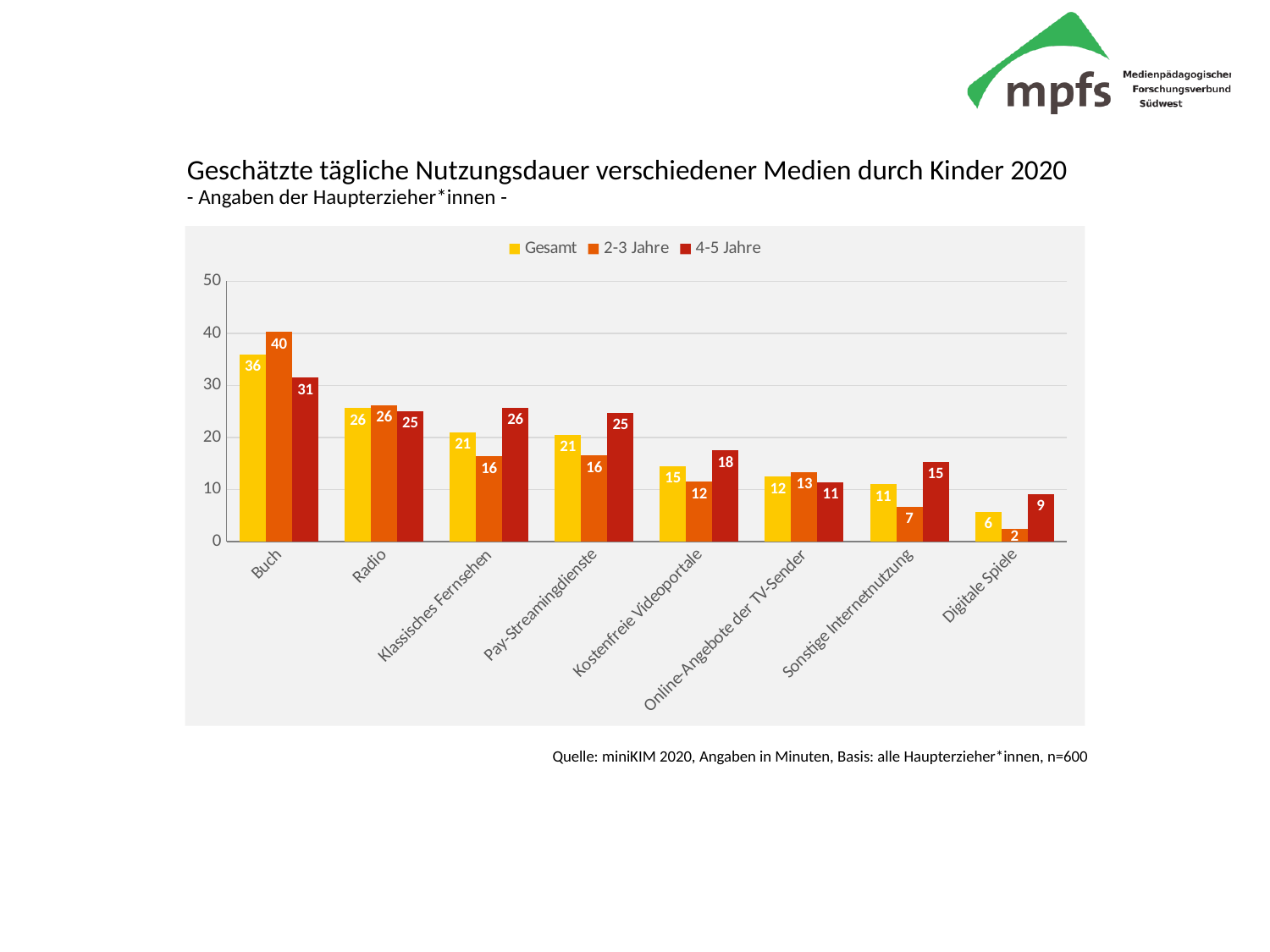
Which category has the highest Gesamt value? Buch What is the difference between the 2-3 Jahre and 4-5 Jahre values for Pay-Streamingdienste? 9 Which is larger for Kostenfreie Videoportale: the 2-3 Jahre value or the 4-5 Jahre value? 4-5 Jahre How many series does the legend list? 3 What kind of chart is shown? bar chart How many categories are shown on the x axis? 8 What is the 4-5 Jahre value for Sonstige Internetnutzung? 15 Is the 2-3 Jahre value for Buch greater or less than 30? greater What is the value for Buch in the 2-3 Jahre series? 40 What is the Gesamt value for Klassisches Fernsehen? 21 What are the three series listed in the legend? Gesamt, 2-3 Jahre, 4-5 Jahre Which category has the lowest 2-3 Jahre value? Digitale Spiele